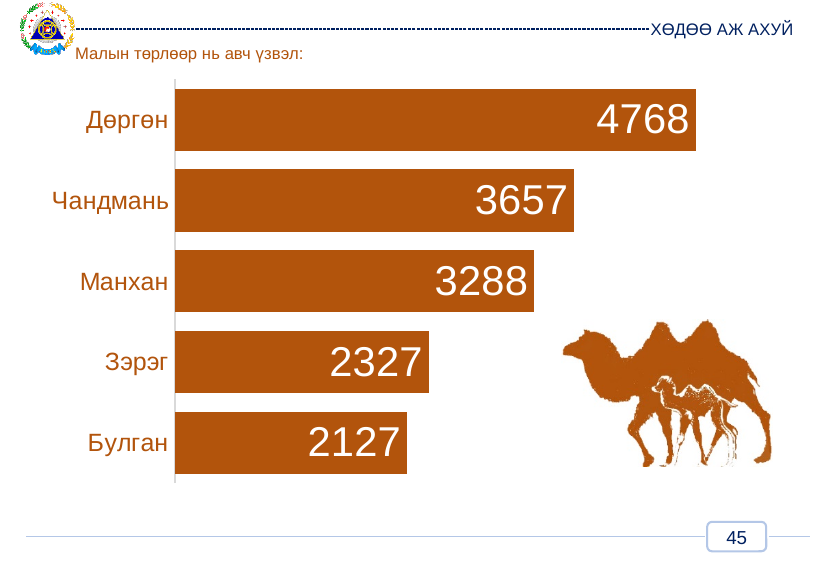
What is the value for Зэрэг? 2327 What is the value for Дөргөн? 4768 Which is larger, the value for Манхан or the value for Зэрэг? Манхан Which category has the lowest value? Булган What is the difference between the values for Зэрэг and Булган? 200 How many categories are shown in the chart? 5 What is the value for Чандмань? 3657 What is the difference between the values for Дөргөн and Чандмань? 1111 What is the value for Булган? 2127 Which category has the highest value? Дөргөн What is the value for Манхан? 3288 What kind of chart is shown on the slide? Bar chart